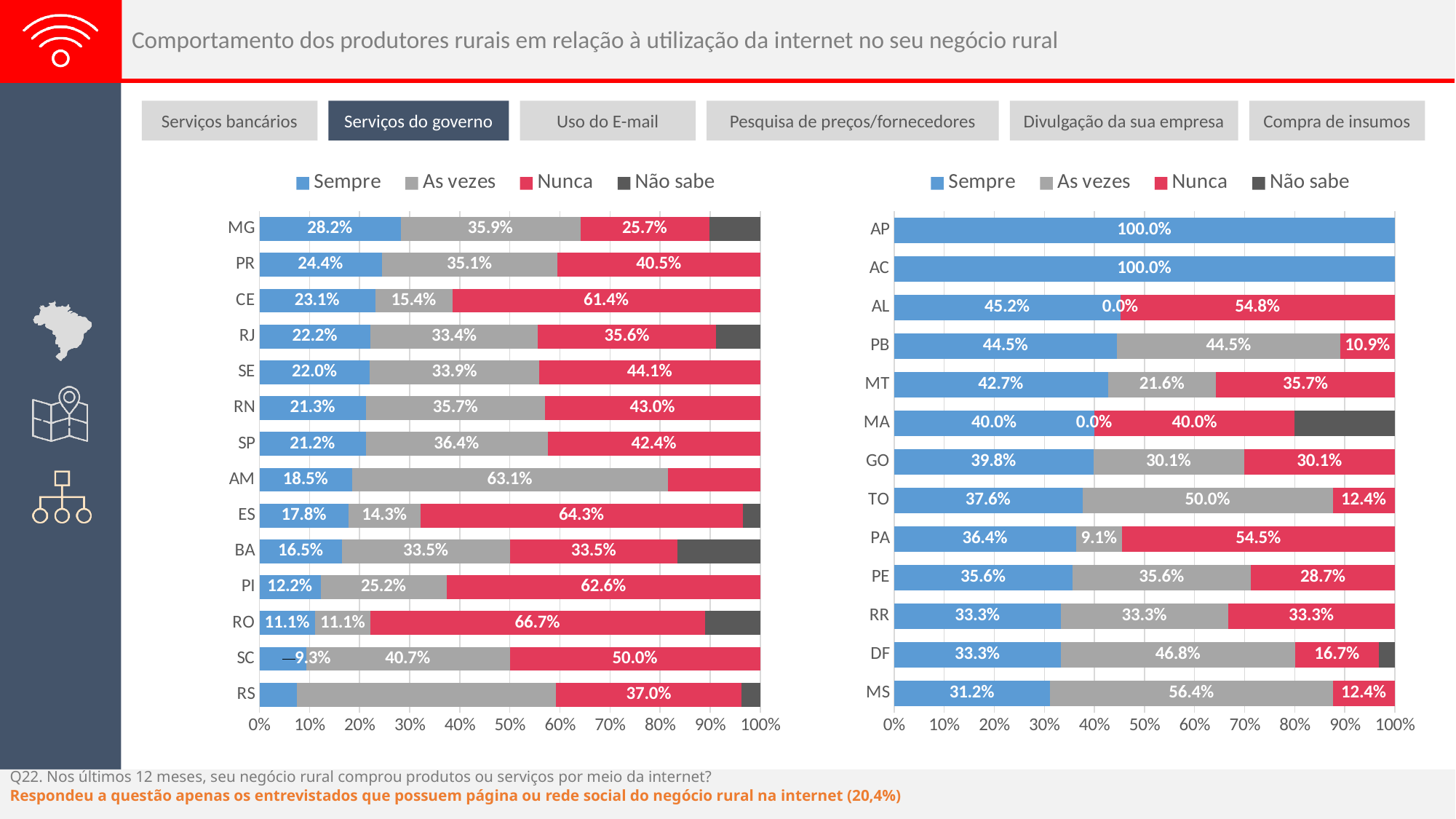
In the left chart, what is the 'Nunca' value for RO? 66.7% In the left chart, what is the 'Sempre' value for MG? 28.2% In the left chart, which state has a larger 'Nunca' value, CE or PR? CE In the left chart, what is the difference between the 'Nunca' and 'Sempre' values for PR? 16.1 percentage points In the right chart, what is the 'Sempre' value for AP? 100.0% How many states are shown in the left chart? 14 In the right chart, what is the 'As vezes' value for MS? 56.4% In the left chart, is the 'Sempre' value for RS greater or less than 10%? less What type of chart is used on this slide? Stacked bar chart How many series does the legend of the right chart list? 4 In the right chart, which state has the lowest 'Sempre' value? MS In the left chart, which state has the highest 'Nunca' value? RO